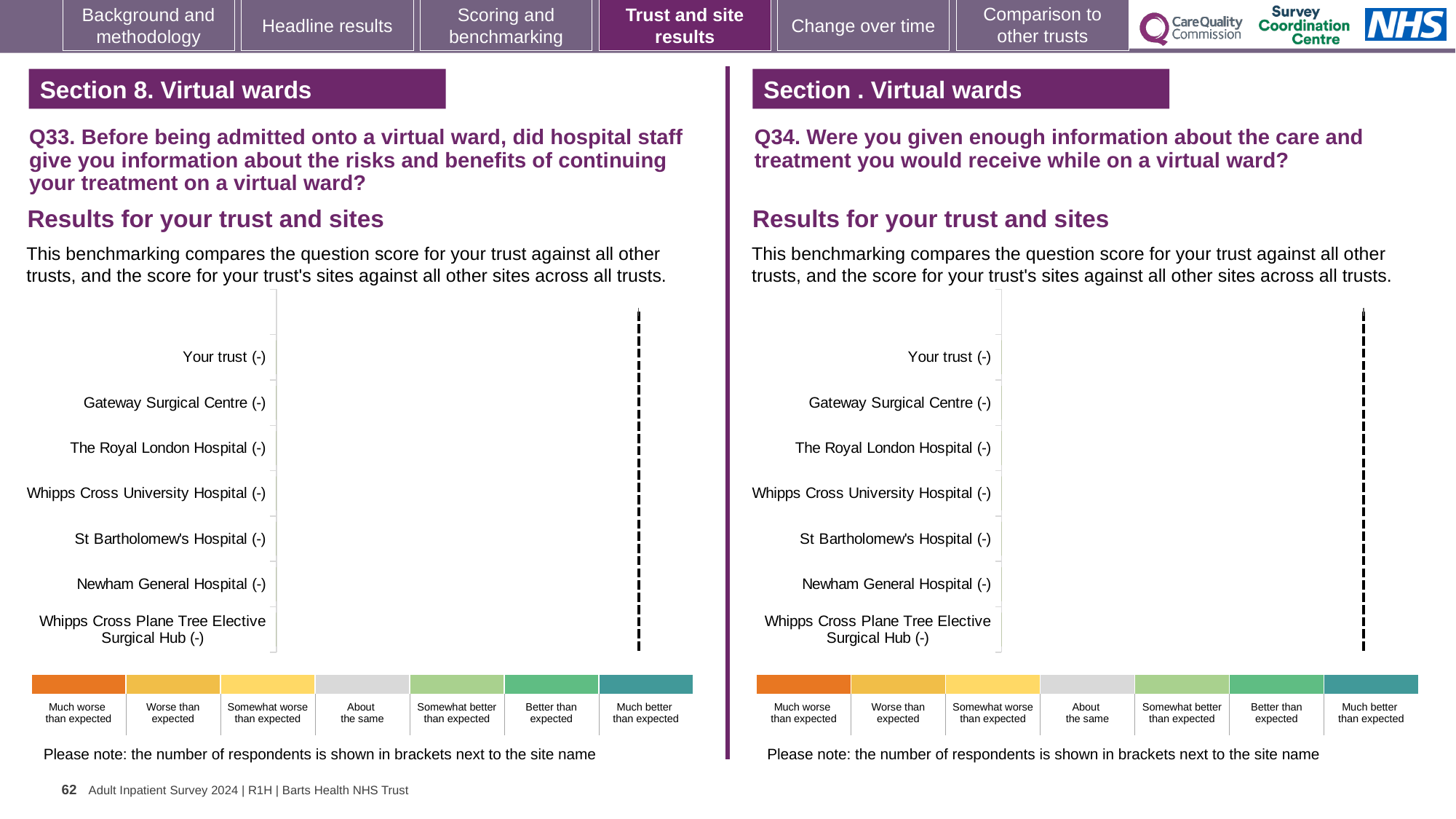
On the Q34 chart on the right, how many benchmark bands are shown in the colour key below the chart? 7 On the Q34 chart on the right, how many sites or trust rows are listed on the vertical axis? 7 On the Q34 chart on the right, what is the last (bottom) category listed on the vertical axis? Whipps Cross Plane Tree Elective Surgical Hub (-) On the Q33 chart on the left, what is shown in brackets next to the site name for The Royal London Hospital? - On the Q33 chart on the left, what is the first (top) category listed on the vertical axis? Your trust (-) On the Q33 chart on the left, how many benchmark bands are shown in the colour key below the chart? 7 On the Q34 chart on the right, what is shown in brackets next to the site name for Newham General Hospital? -